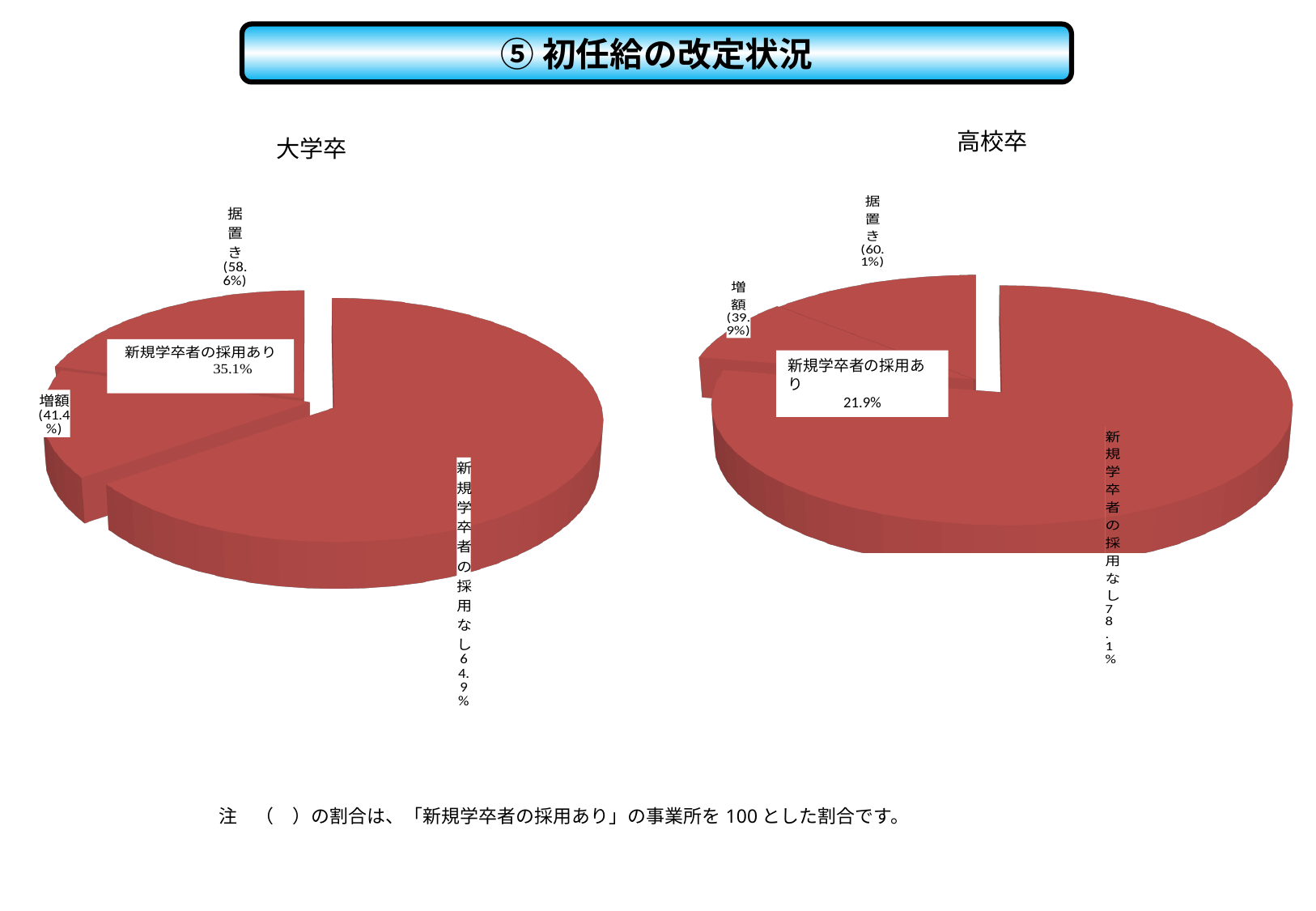
In the 大学卒 chart, what percentage is shown for 新規学卒者の採用あり? 35.1% What is the title of the slide? ⑤ 初任給の改定状況 Which chart shows the higher percentage for 新規学卒者の採用あり, 大学卒 or 高校卒? 大学卒 In the 高校卒 chart, what percentage is shown in parentheses for 増額? 39.9% In the 大学卒 chart, which is larger, 新規学卒者の採用なし or 新規学卒者の採用あり? 新規学卒者の採用なし In the 大学卒 chart, what percentage is shown for 新規学卒者の採用なし? 64.9% What kind of chart is used for 大学卒? Pie chart What is the difference in percentage points between 新規学卒者の採用なし in the 高校卒 chart and in the 大学卒 chart? 13.2 In the 高校卒 chart, what is the difference in percentage points between 据置き (60.1%) and 増額 (39.9%)? 20.2 In the 高校卒 chart, what percentage is shown for 新規学卒者の採用なし? 78.1% In the 大学卒 chart, what percentage is shown in parentheses for 据置き? 58.6% In the 高校卒 chart, what percentage is shown for 新規学卒者の採用あり? 21.9%